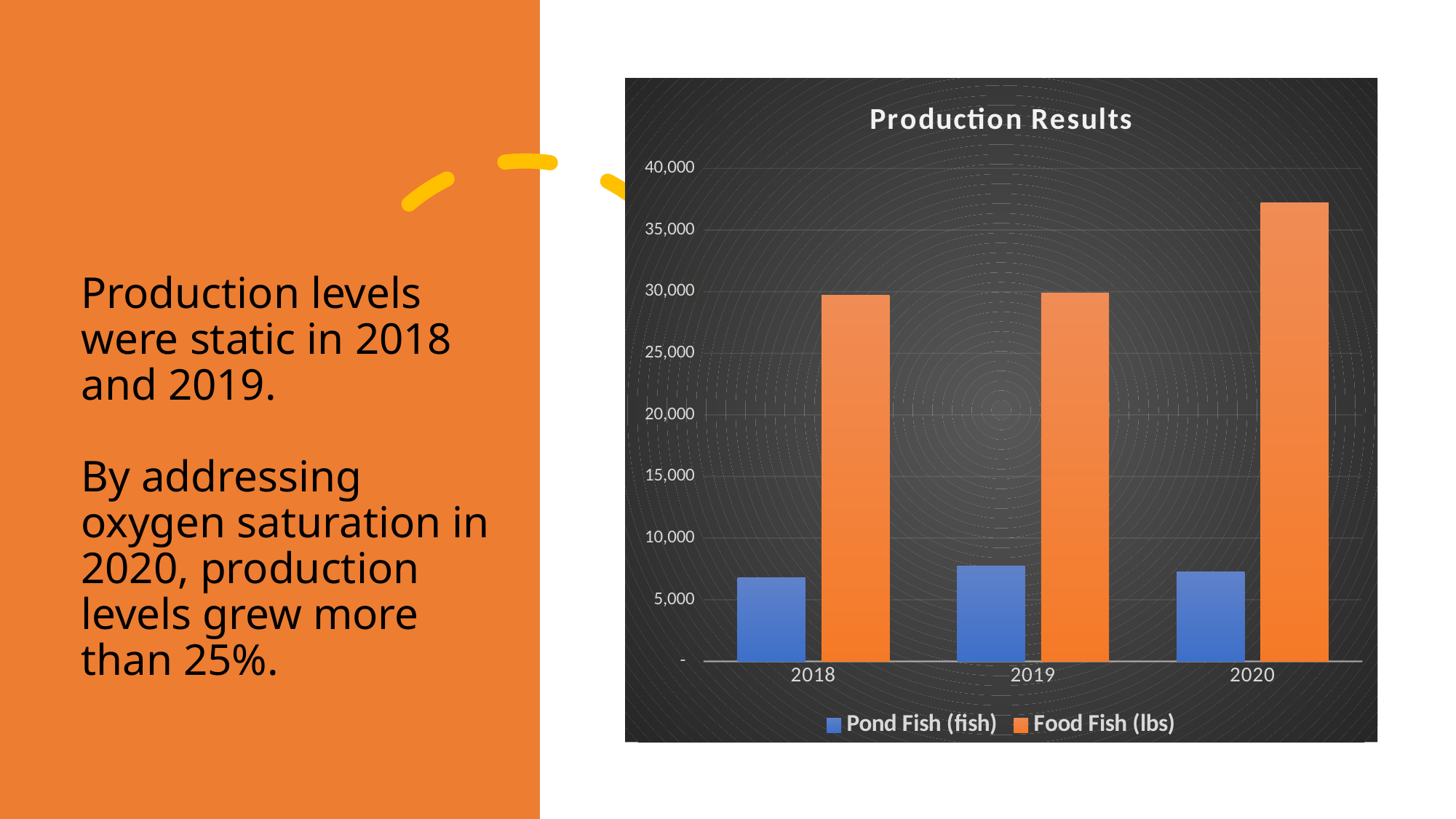
In which year is the Pond Fish (fish) value highest? 2019 How many series does the legend list? 2 How many years are shown on the x axis of the chart? 3 Is the Food Fish (lbs) value for 2020 greater or less than 35,000? greater What is the title of the chart? Production Results Is the Pond Fish (fish) value for 2019 greater or less than 10,000? less Is the Pond Fish (fish) value for 2018 greater or less than 5,000? greater What type of chart is shown on the slide? bar chart Which is larger in 2020: the Pond Fish (fish) value or the Food Fish (lbs) value? Food Fish (lbs) In which year is the Food Fish (lbs) value highest? 2020 Which series is shown in orange in the chart? Food Fish (lbs)